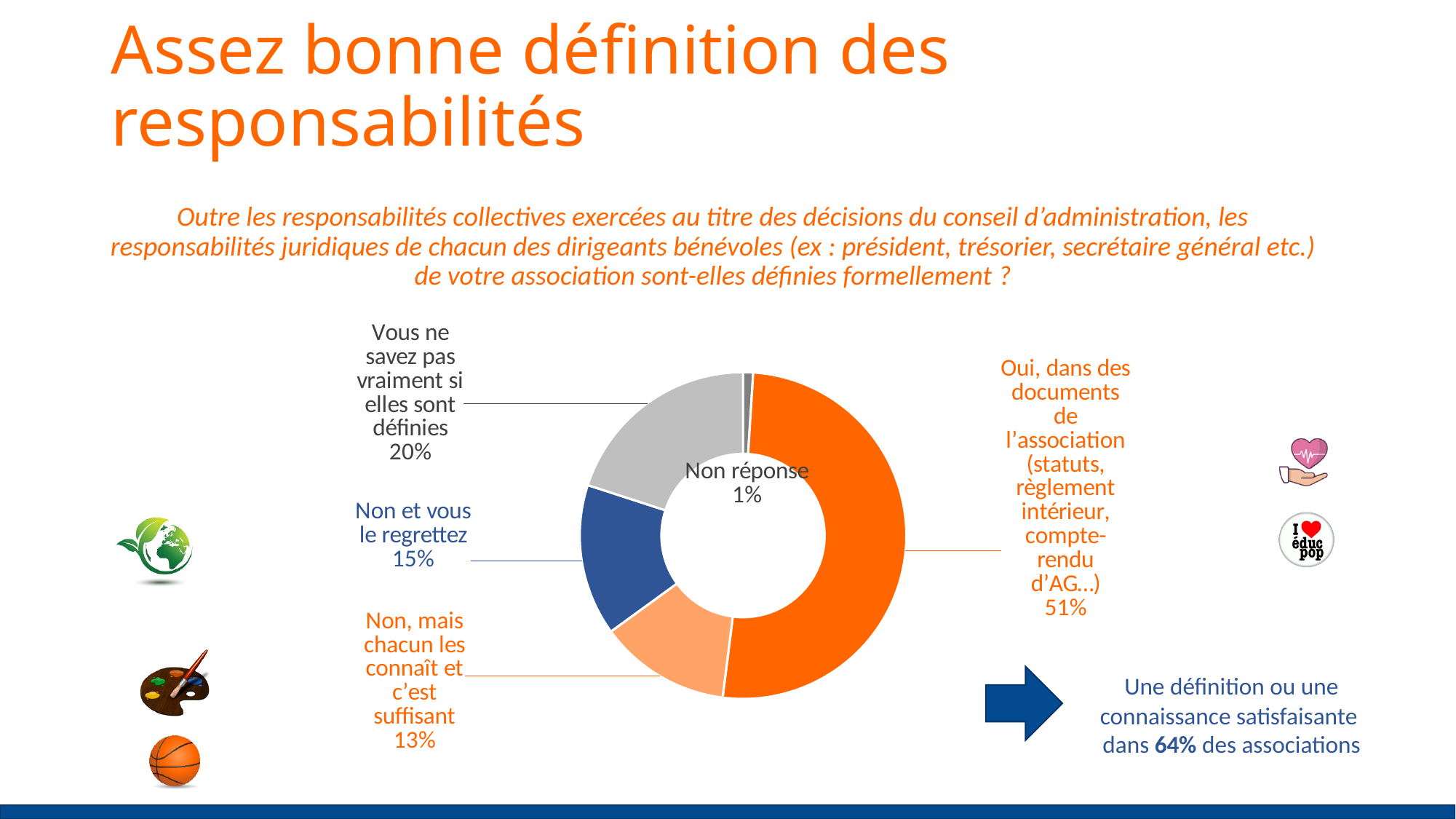
Which is larger: the share for "Non et vous le regrettez" or the share for "Non, mais chacun les connaît et c'est suffisant"? Non et vous le regrettez Which category has the largest share of the chart? Oui, dans des documents de l'association (statuts, règlement intérieur, compte-rendu d'AG…) What percentage corresponds to "Non et vous le regrettez"? 15% What is the combined share of "Oui, dans des documents de l'association" and "Non, mais chacun les connaît et c'est suffisant"? 64% What share of associations answered "Oui, dans des documents de l'association (statuts, règlement intérieur, compte-rendu d'AG…)"? 51% What is the share of "Non réponse" in the chart? 1% What percentage corresponds to "Vous ne savez pas vraiment si elles sont définies"? 20% What is the difference between the share for "Oui, dans des documents de l'association" and the share for "Vous ne savez pas vraiment si elles sont définies"? 31% Which category has the smallest share of the chart? Non réponse How many categories are shown in the chart? 5 What type of chart is shown on the slide? Doughnut chart What percentage corresponds to "Non, mais chacun les connaît et c'est suffisant"? 13%